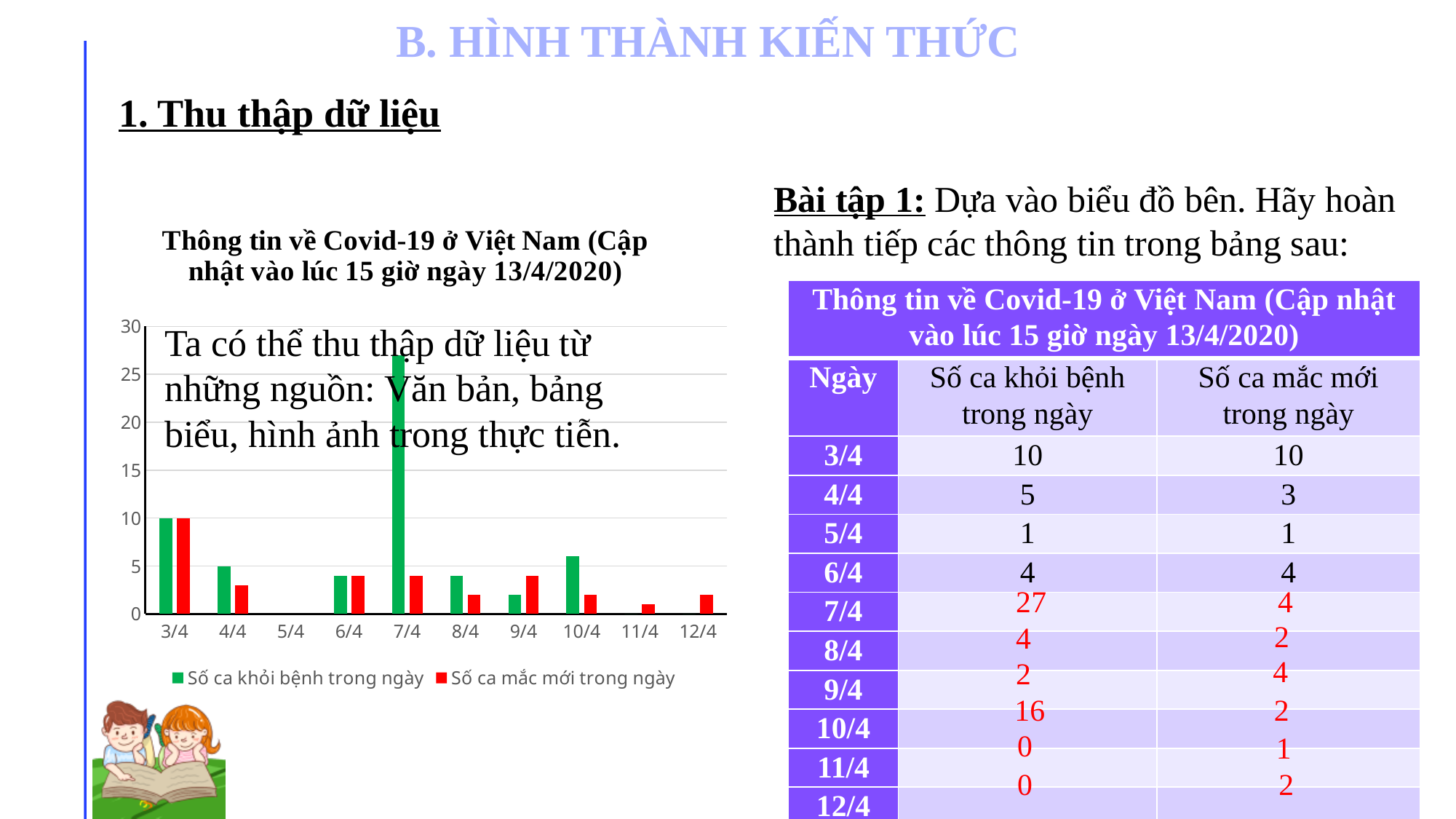
What kind of chart is shown on the slide? bar chart On which date is the number of recovered cases (Số ca khỏi bệnh trong ngày) highest? 7/4 How many series does the chart legend list? 2 What is the value of Số ca khỏi bệnh trong ngày on 3/4? 10 Is the value for Số ca khỏi bệnh trong ngày on 7/4 greater or less than 25? greater What is the value of Số ca mắc mới trong ngày on 3/4? 10 On 10/4, which is larger: Số ca khỏi bệnh trong ngày or Số ca mắc mới trong ngày? Số ca khỏi bệnh trong ngày Which colour represents Số ca mắc mới trong ngày in the chart? red What is the value of Số ca khỏi bệnh trong ngày on 4/4? 5 Is the value for Số ca khỏi bệnh trong ngày on 10/4 greater or less than 5? greater On 9/4, which is larger: Số ca khỏi bệnh trong ngày or Số ca mắc mới trong ngày? Số ca mắc mới trong ngày How many dates are shown on the x axis of the chart? 10